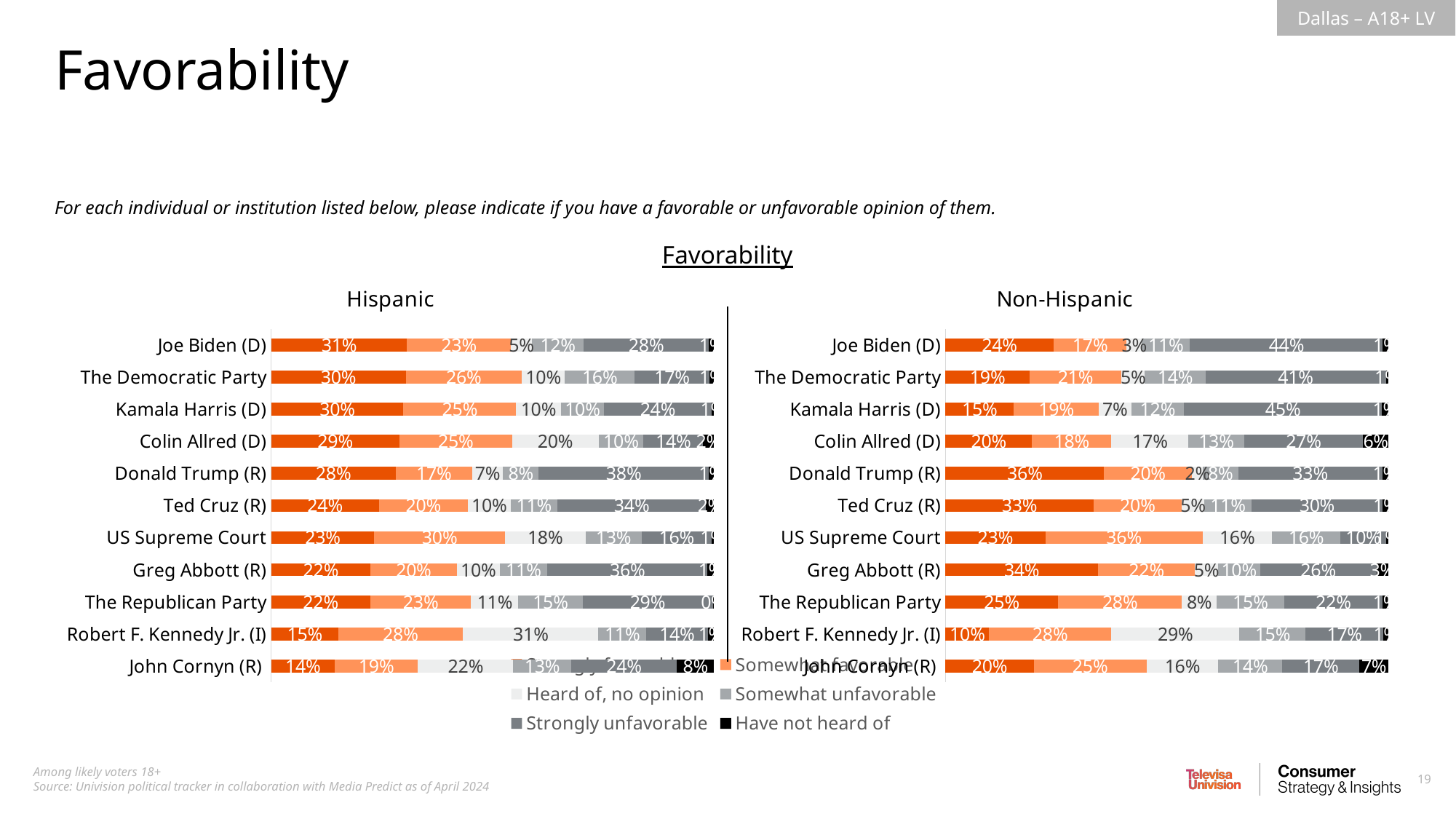
In the Non-Hispanic chart, what percentage of respondents are strongly unfavorable toward Kamala Harris (D)? 45% In the Hispanic chart, who has the larger 'Strongly unfavorable' percentage, Donald Trump (R) or Greg Abbott (R)? Donald Trump (R) What is the difference between Donald Trump's 'Strongly favorable' percentage in the Non-Hispanic chart and in the Hispanic chart? 8 percentage points In the Hispanic chart, which individual or institution has the lowest 'Strongly favorable' percentage? John Cornyn (R) In the Non-Hispanic chart, which individual or institution has the highest 'Strongly favorable' percentage? Donald Trump (R) In the Hispanic chart, what is the 'Heard of, no opinion' value for Robert F. Kennedy Jr. (I)? 31% In the Non-Hispanic chart, what is the 'Somewhat favorable' value for the US Supreme Court? 36% In the Hispanic chart, what percentage of respondents are strongly favorable toward Joe Biden (D)? 31% How many response categories does the legend list? 6 What type of chart is used to show the favorability results? Stacked bar chart In the Hispanic chart, which individual or institution has the highest 'Strongly favorable' percentage? Joe Biden (D) How many individuals or institutions are listed in the Hispanic chart? 11